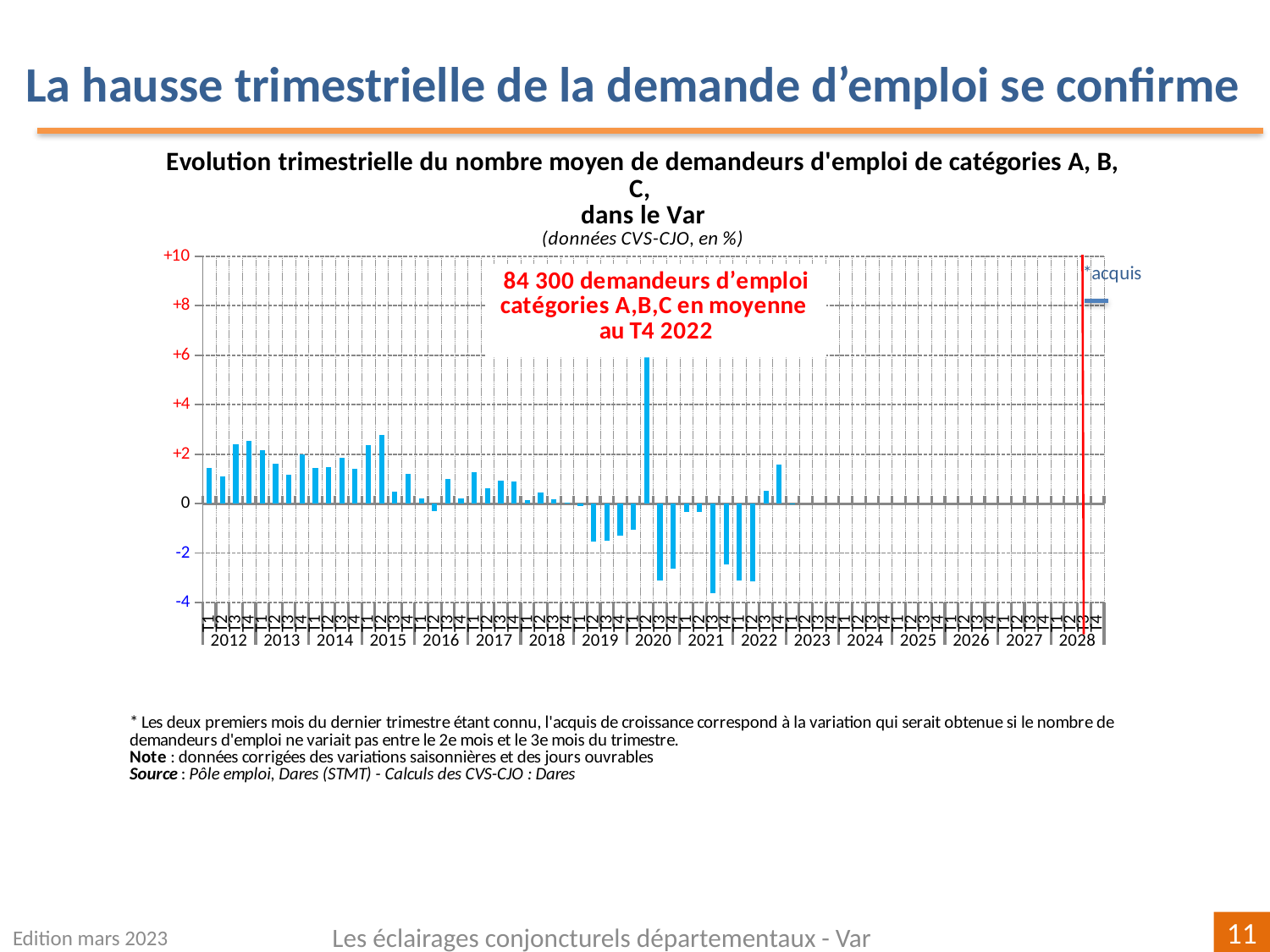
Is the value for 2015 T2 greater or less than +2? greater Is the value of the tallest bar (2020 T2) greater or less than +4? greater Is the value for 2020 T3 greater or less than -2? less What kind of chart is shown on the slide? bar chart In which year does the tallest bar of the chart occur? 2020 What is the lowest value shown on the vertical axis? -4 How many years are labelled along the x axis of the chart? 17 Which is larger, the value for 2020 T2 or the value for 2015 T2? 2020 T2 What is the highest value shown on the vertical axis? +10 According to the text box on the chart, how many demandeurs d'emploi catégories A,B,C were there on average in T4 2022? 84 300